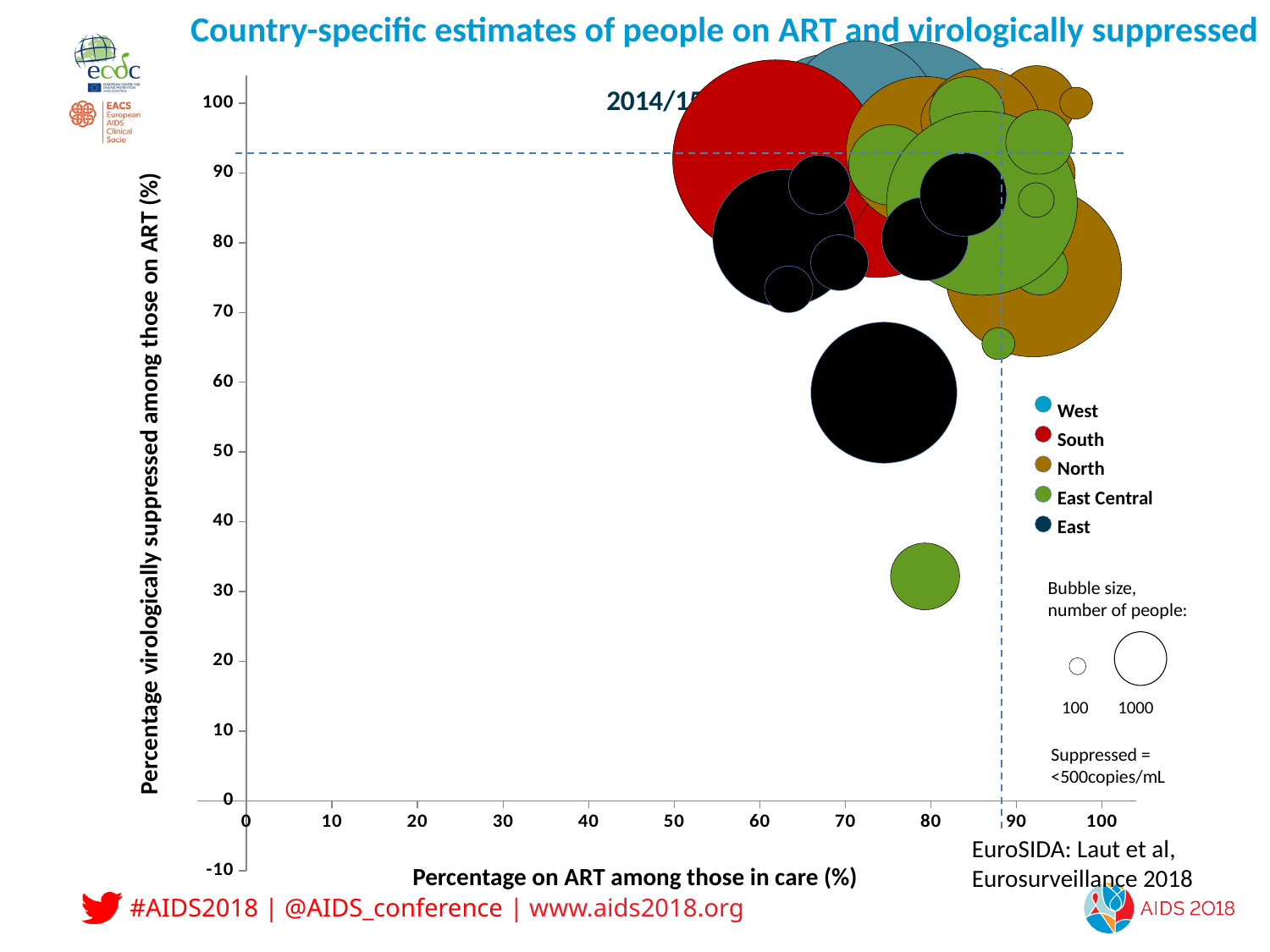
What does bubble size represent according to the chart? Number of people Which region is shown in green in the legend? East Central Is the large black (East) bubble near the middle of the chart greater or less than 70 on the y axis? less Is the large red (South) bubble's value on the x axis greater or less than 40? greater What two reference bubble sizes are shown in the bubble size key? 100 and 1000 Which region is shown in red in the legend? South What is the label of the x axis? Percentage on ART among those in care (%) What kind of chart is shown on the slide? Bubble chart How many regions does the legend list? 5 What is the title of the chart? Country-specific estimates of people on ART and virologically suppressed Is the lowest East Central (green) bubble's value on the y axis greater or less than 40? less What threshold defines 'suppressed' on the chart? <500 copies/mL